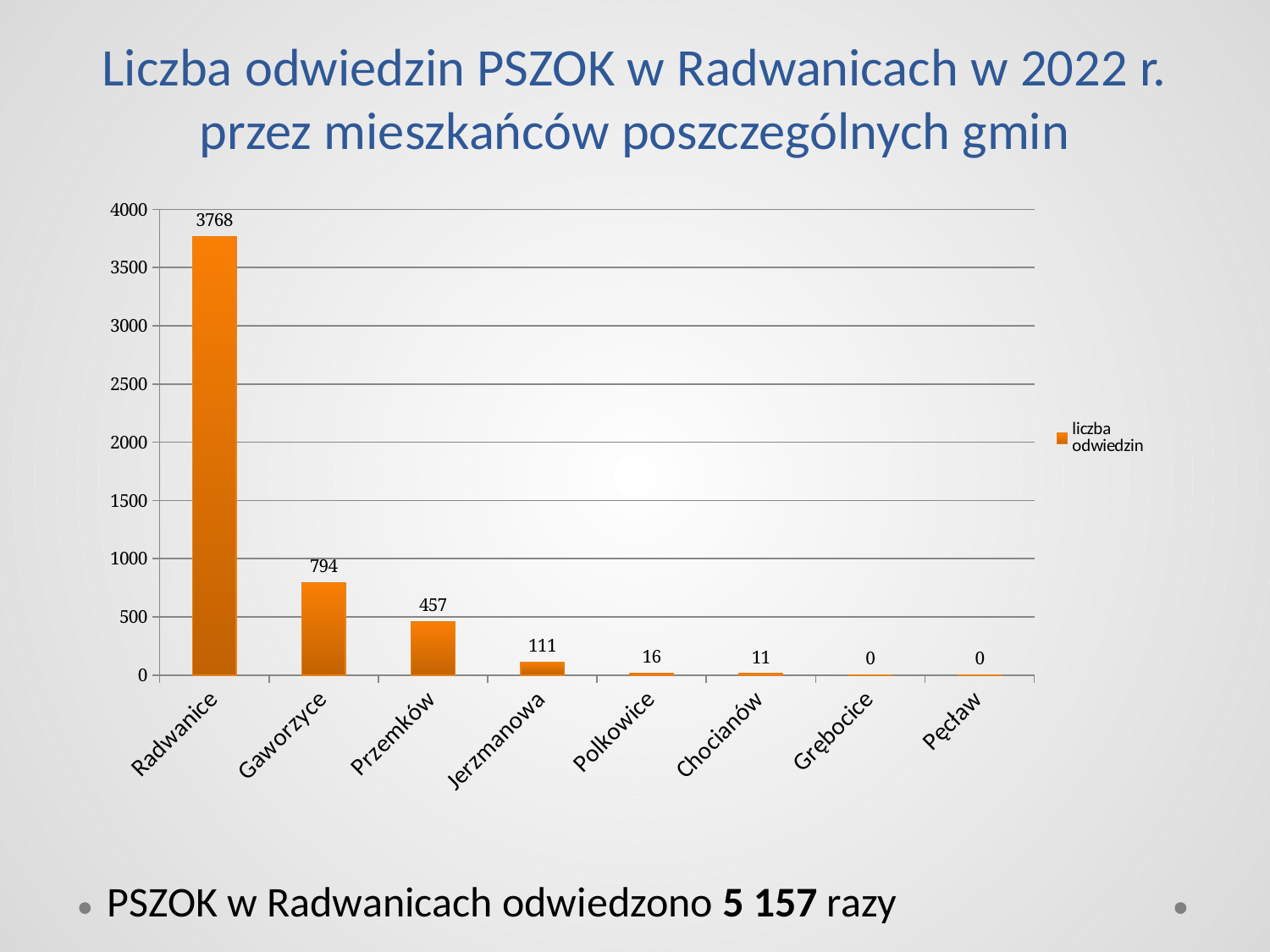
How many series does the legend list? 1 What is the difference between the values for Przemków and Jerzmanowa? 346 What is the value shown for Jerzmanowa? 111 What kind of chart is shown on the slide? Bar chart What is the legend entry for the series shown? liczba odwiedzin What is the difference between the values for Radwanice and Gaworzyce? 2974 Which is larger, the value for Polkowice or the value for Chocianów? Polkowice Which municipality has the highest number of visits? Radwanice What is the value shown for Polkowice? 16 How many municipalities are shown on the x axis? 8 Which municipalities have a value of 0? Grębocice and Pęcław What is the number of visits (liczba odwiedzin) for Gaworzyce? 794